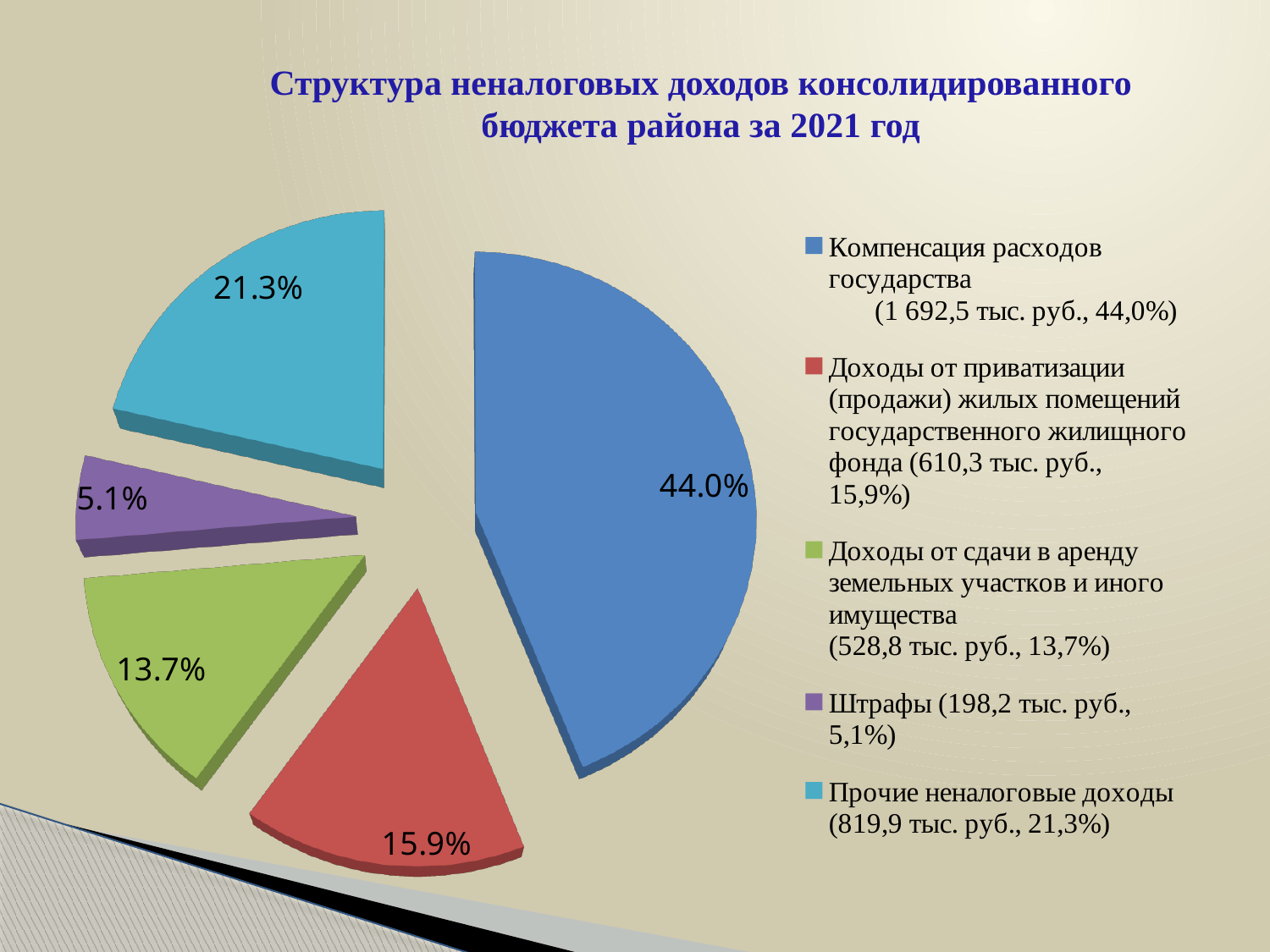
According to the legend, what amount in thousand rubles corresponds to "Прочие неналоговые доходы"? 819,9 тыс. руб. What share of the pie does "Компенсация расходов государства" account for? 44.0% Which slice is larger: "Доходы от приватизации (продажи) жилых помещений государственного жилищного фонда" or "Доходы от сдачи в аренду земельных участков и иного имущества"? Доходы от приватизации (продажи) жилых помещений государственного жилищного фонда How many slices does the pie chart have? 5 Which category has the largest slice of the pie? Компенсация расходов государства Which category has the smallest slice of the pie? Штрафы According to the legend, what amount in thousand rubles corresponds to "Штрафы"? 198,2 тыс. руб. What colour is the slice for "Штрафы"? purple What share of the pie does "Прочие неналоговые доходы" account for? 21.3% What share of the pie does "Штрафы" account for? 5.1% By how many percentage points does the share of "Компенсация расходов государства" exceed the share of "Прочие неналоговые доходы"? 22.7 percentage points What kind of chart is shown on the slide? pie chart